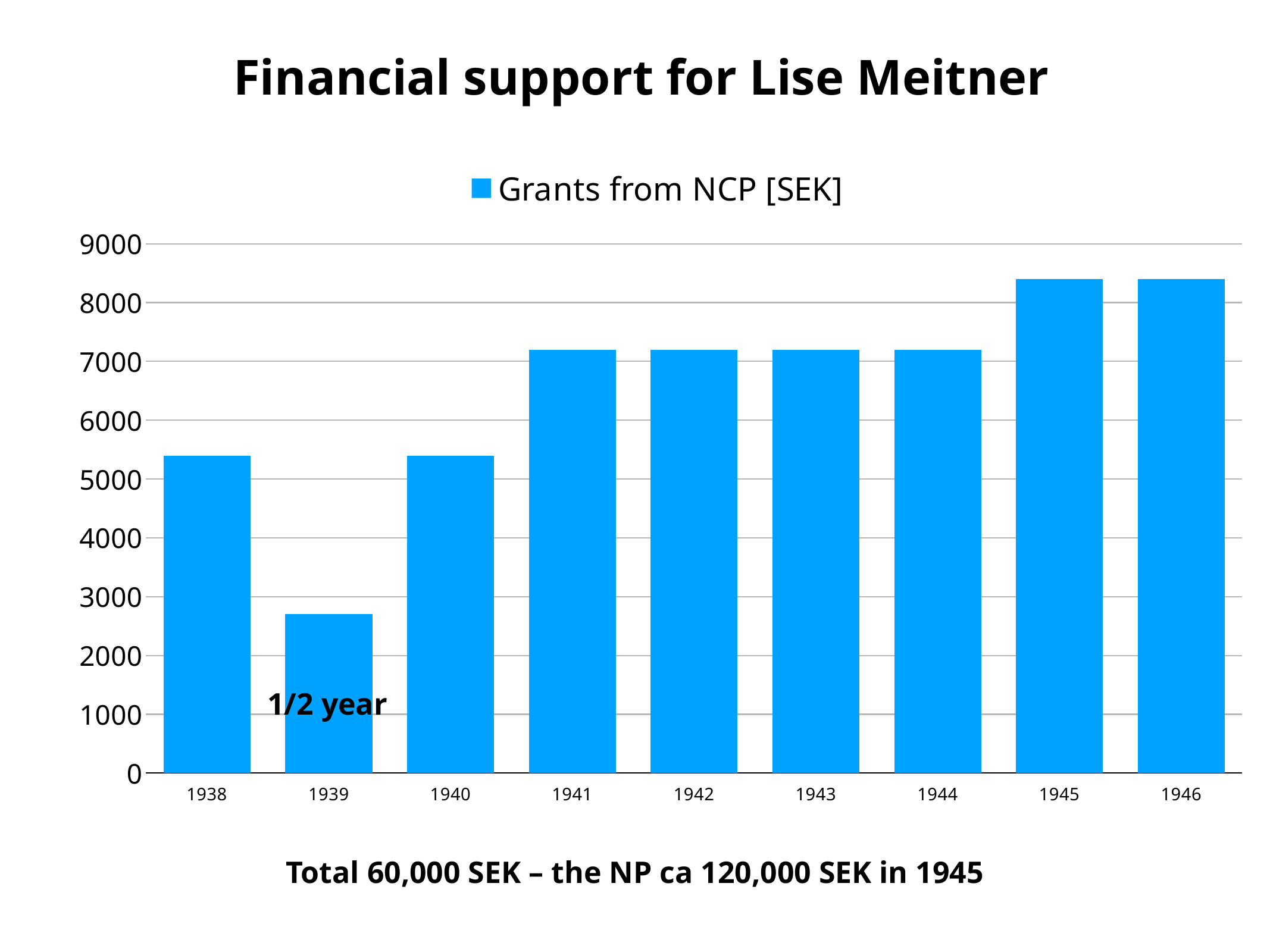
Is the value for 1938 greater or less than 5000? greater Which is larger, the grant for 1940 or the grant for 1941? 1941 Which year has the lowest grant from NCP? 1939 How many series does the legend list? 1 Is the value for 1939 greater or less than 3000? less Is the value for 1945 greater or less than 9000? less What is the legend entry for the series shown? Grants from NCP [SEK] What is the title of the chart? Financial support for Lise Meitner What kind of chart is shown on the slide? bar chart Which is larger, the grant for 1944 or the grant for 1946? 1946 How many years are shown on the x axis of the chart? 9